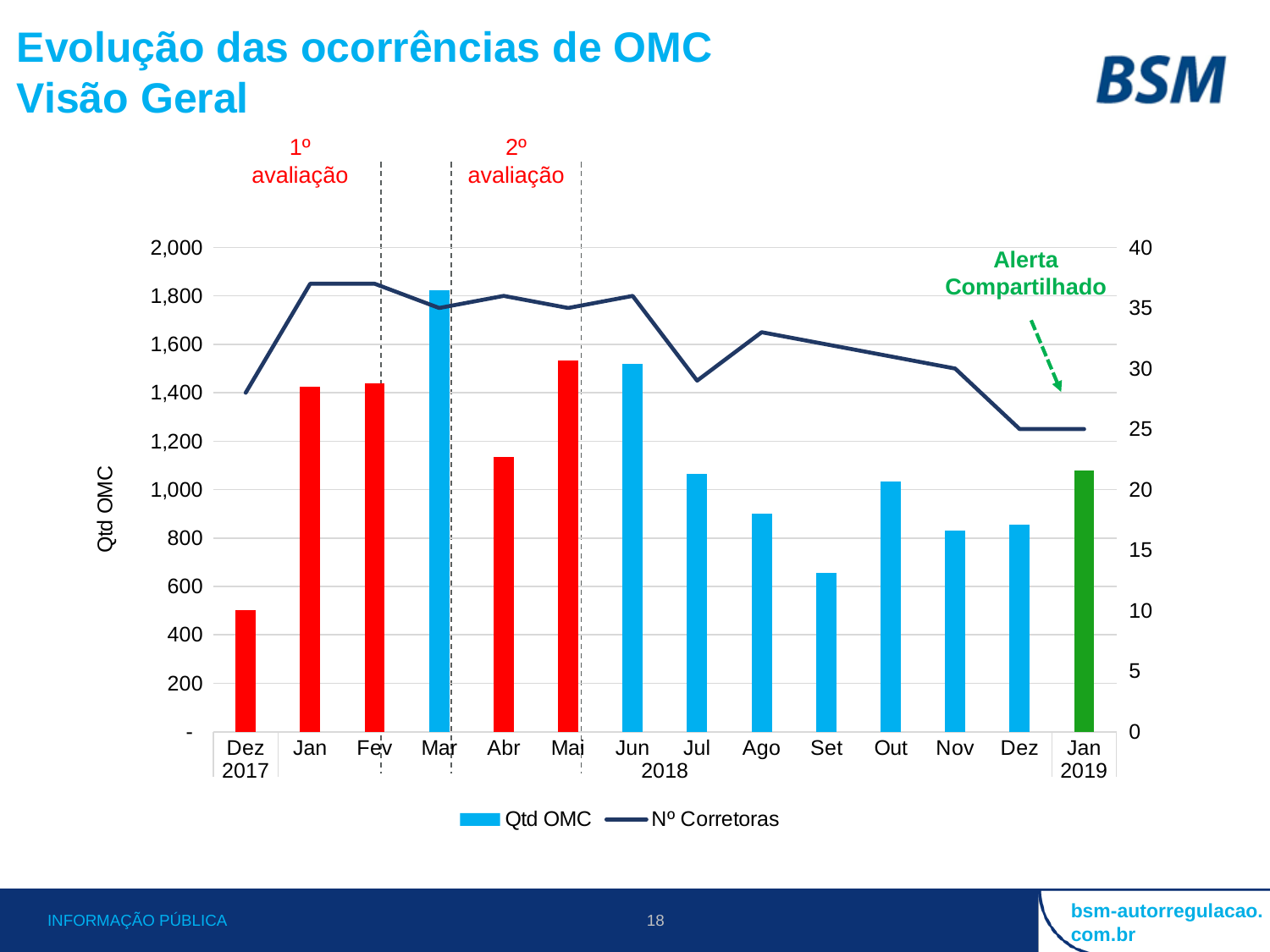
Is the Qtd OMC value for Set 2018 greater or less than 800? less What kind of chart is shown on the slide? A combined bar and line chart Is the Qtd OMC value for Dez 2017 greater or less than 600? less Which has the larger Qtd OMC bar, Abr 2018 or Mai 2018? Mai 2018 Which month has the lowest Qtd OMC bar? Dez 2017 How many months are shown on the x axis? 14 Is the Qtd OMC value for Mar 2018 greater or less than 1,600? greater How many series does the legend list? 2 What are the two series named in the legend? Qtd OMC and Nº Corretoras Which month has the highest Qtd OMC bar? Mar 2018 Does the Nº Corretoras line rise or fall from Jun 2018 to Dez 2018? fall